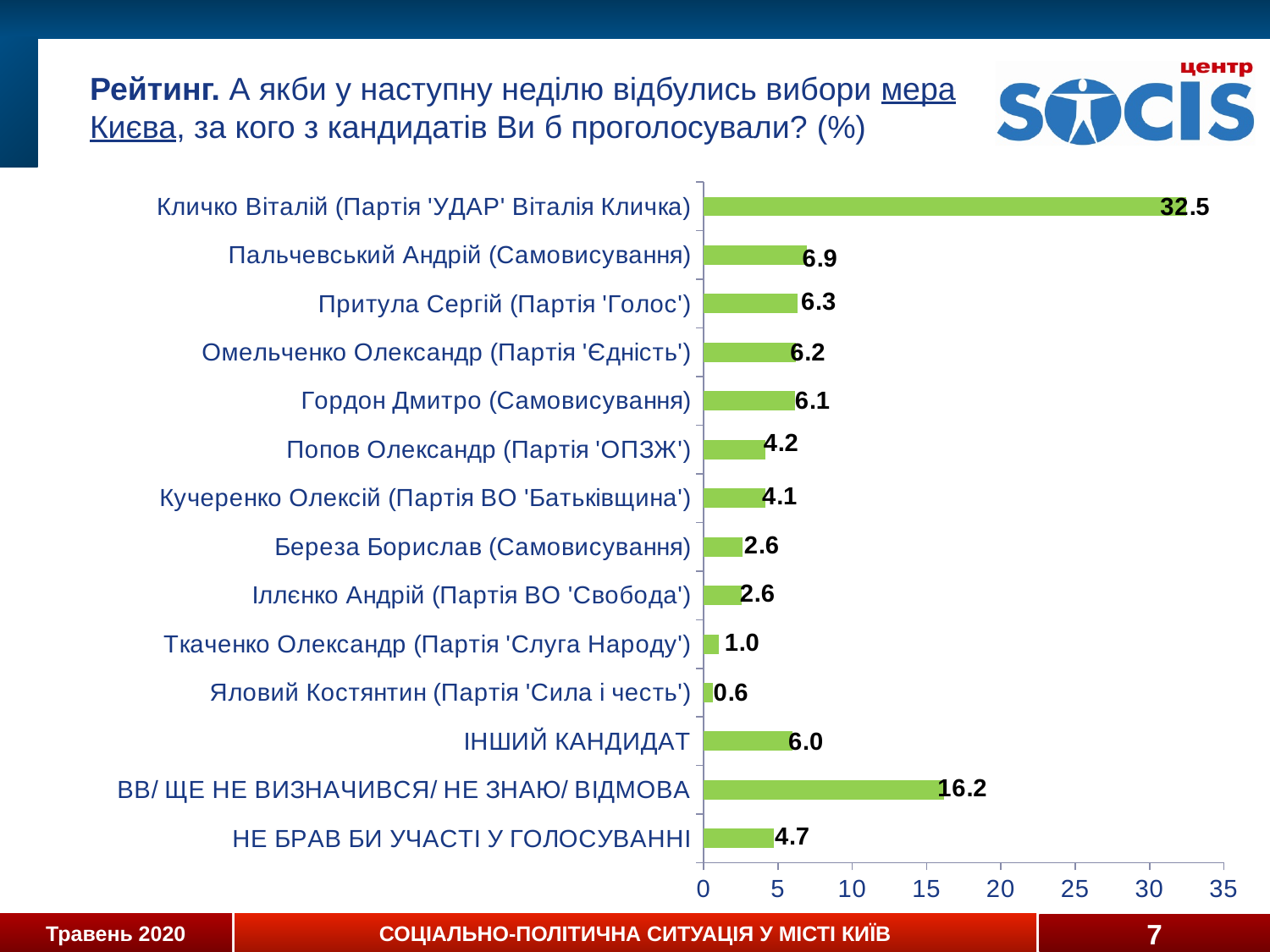
What is the difference between the values for Кличко Віталій and ВВ/ ЩЕ НЕ ВИЗНАЧИВСЯ/ НЕ ЗНАЮ/ ВІДМОВА? 16.3 What is the value for Ткаченко Олександр (Партія 'Слуга Народу')? 1.0 What is the value for Кличко Віталій (Партія 'УДАР' Віталія Кличка)? 32.5 Which category has the lowest value? Яловий Костянтин (Партія 'Сила і честь') What is the value for НЕ БРАВ БИ УЧАСТІ У ГОЛОСУВАННІ? 4.7 How many categories are plotted in the chart? 14 What type of chart is shown on the slide? bar chart Which is larger: the value for Пальчевський Андрій (Самовисування) or the value for Попов Олександр (Партія 'ОПЗЖ')? Пальчевський Андрій (Самовисування) Is the value for Кличко Віталій greater or less than 30? greater What is the value for Гордон Дмитро (Самовисування)? 6.1 Which category has the highest value? Кличко Віталій (Партія 'УДАР' Віталія Кличка) What is the value for ВВ/ ЩЕ НЕ ВИЗНАЧИВСЯ/ НЕ ЗНАЮ/ ВІДМОВА? 16.2